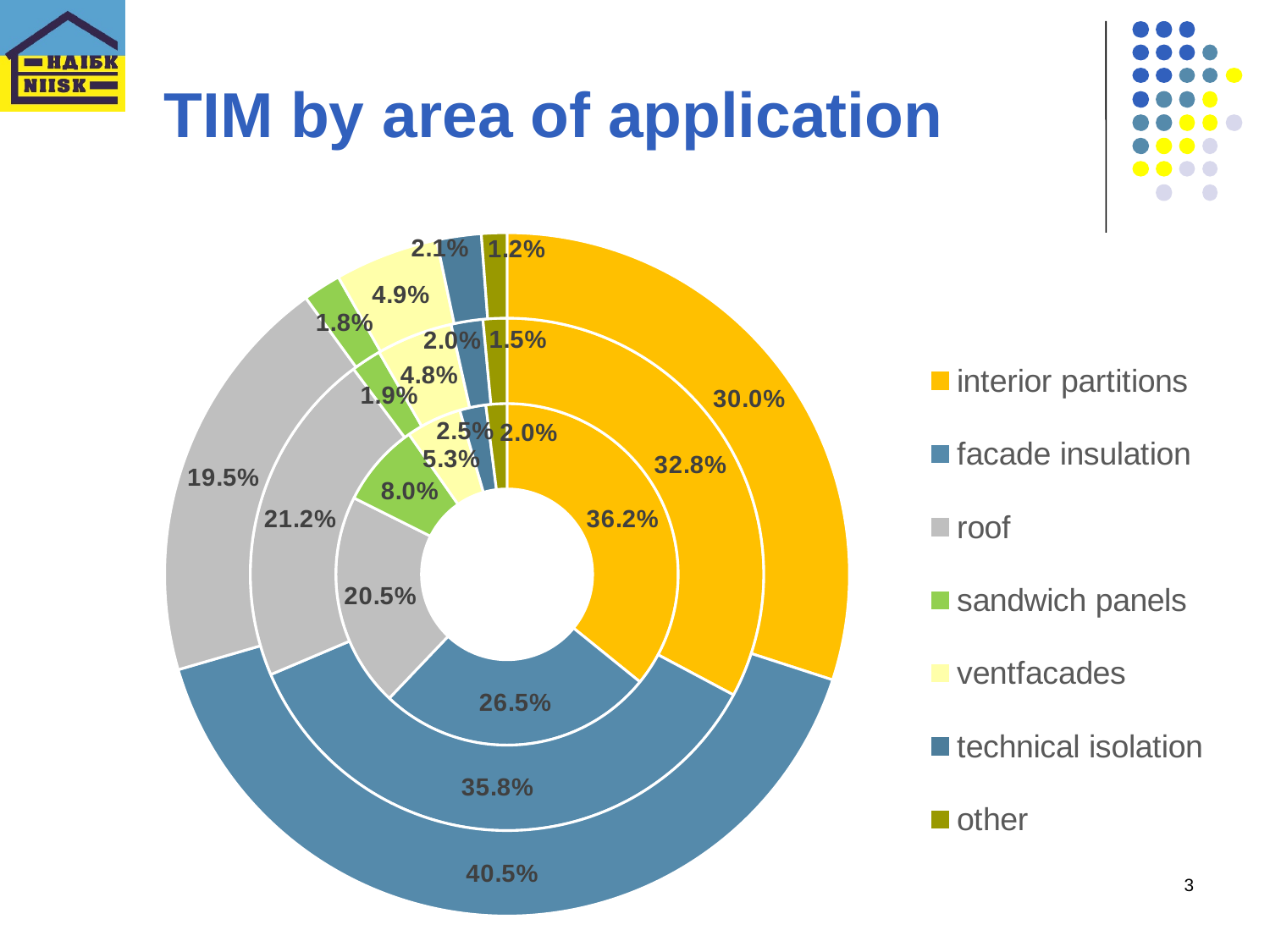
How many rings (series) does the doughnut chart have? 3 What is the value for roof in the middle ring? 21.2% How many categories does the legend list? 7 What is the difference between facade insulation and interior partitions in the outer ring? 10.5% What is the title of the chart? TIM by area of application In the inner ring, which is larger: interior partitions or facade insulation? interior partitions Which category has the smallest share in the outer ring? other What is the value for sandwich panels in the inner ring? 8.0% What is the value for facade insulation in the outer ring? 40.5% What is the value for interior partitions in the inner ring? 36.2% Which category has the largest share in the outer ring? facade insulation What kind of chart is shown on the slide? doughnut chart